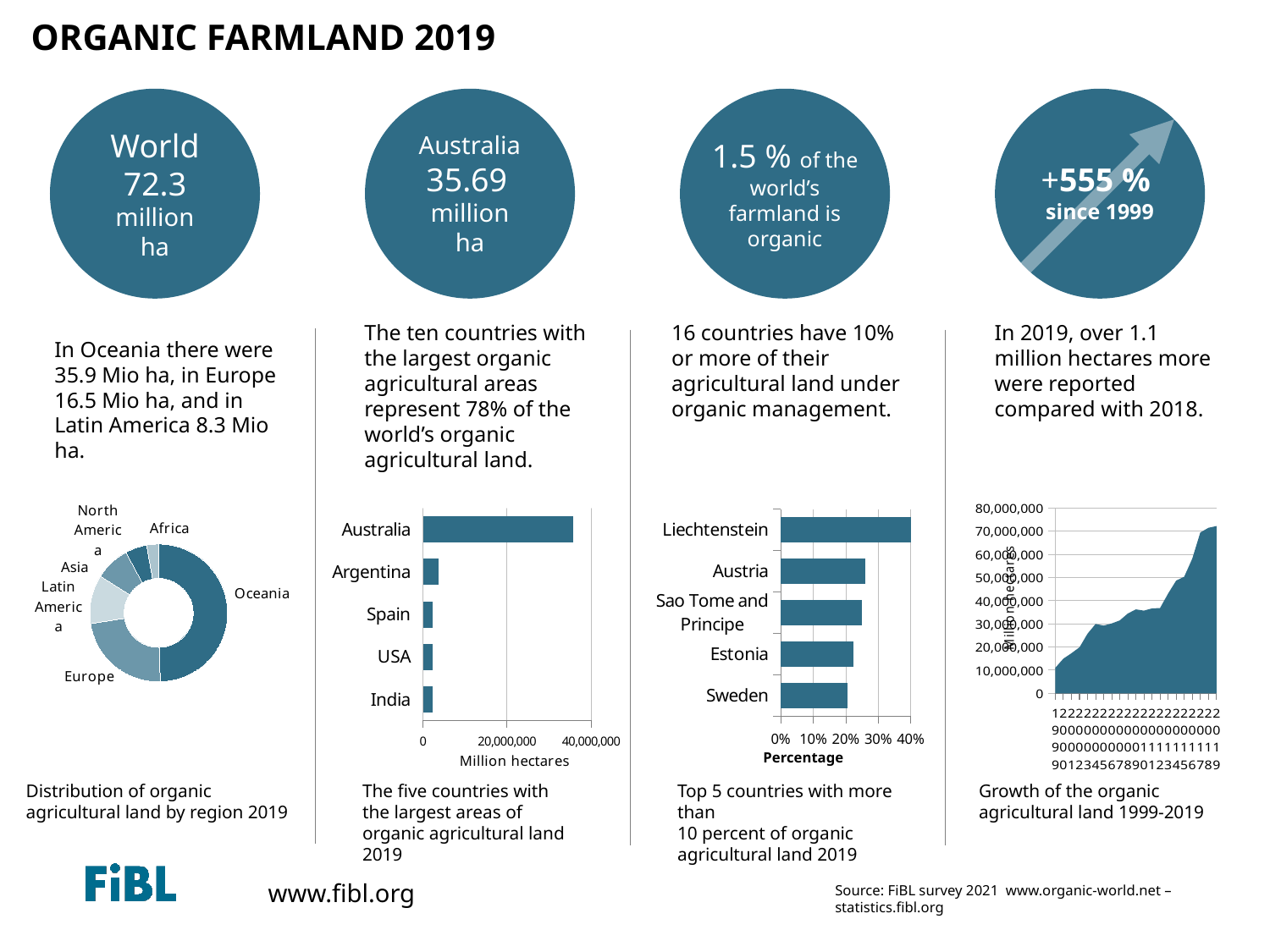
What kind of chart is 'The five countries with the largest areas of organic agricultural land 2019'? bar chart In the 'Distribution of organic agricultural land by region 2019' chart, which slice is larger, Oceania or Europe? Oceania In the 'Top 5 countries with more than 10 percent of organic agricultural land 2019' chart, is the value for Liechtenstein greater or less than 30%? greater In the 'Top 5 countries with more than 10 percent of organic agricultural land 2019' chart, which country has the highest value? Liechtenstein In 'The five countries with the largest areas of organic agricultural land 2019' chart, is the value for Argentina greater or less than 20,000,000? less How many regions are shown in the 'Distribution of organic agricultural land by region 2019' chart? 6 In 'The five countries with the largest areas of organic agricultural land 2019' chart, is the value for Australia greater or less than 20,000,000? greater In the 'Growth of the organic agricultural land 1999-2019' chart, do the values rise or fall from 1999 to 2019? rise In 'The five countries with the largest areas of organic agricultural land 2019' chart, which country has the highest value? Australia In the 'Distribution of organic agricultural land by region 2019' chart, which region has the largest slice? Oceania What is the x-axis title of 'The five countries with the largest areas of organic agricultural land 2019' chart? Million hectares What kind of chart is the 'Distribution of organic agricultural land by region 2019' chart? doughnut chart